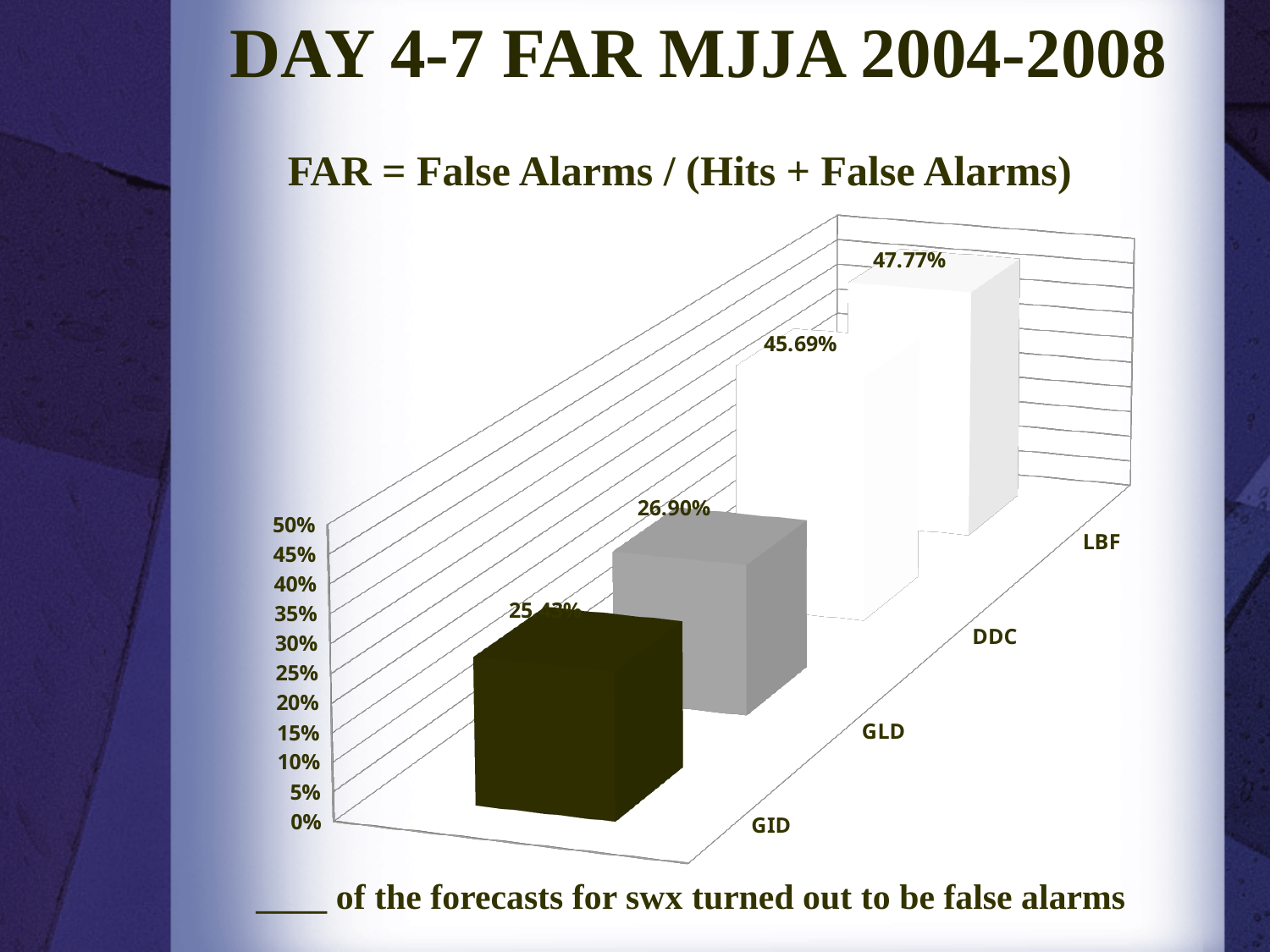
Do the values rise or fall from GID to LBF along the x axis? rise What is the value for DDC? 45.69% What is the difference between the values for DDC and GLD? 18.79% Which category has the highest value? LBF What is the title of the slide containing the chart? DAY 4-7 FAR MJJA 2004-2008 Which is larger, the value for GLD or the value for DDC? DDC What is the value for GLD? 26.90% What kind of chart is shown on the slide? bar chart What is the difference between the values for LBF and DDC? 2.08% Is the value for GID greater or less than 20%? greater How many categories are shown on the chart? 4 What is the value for LBF? 47.77%